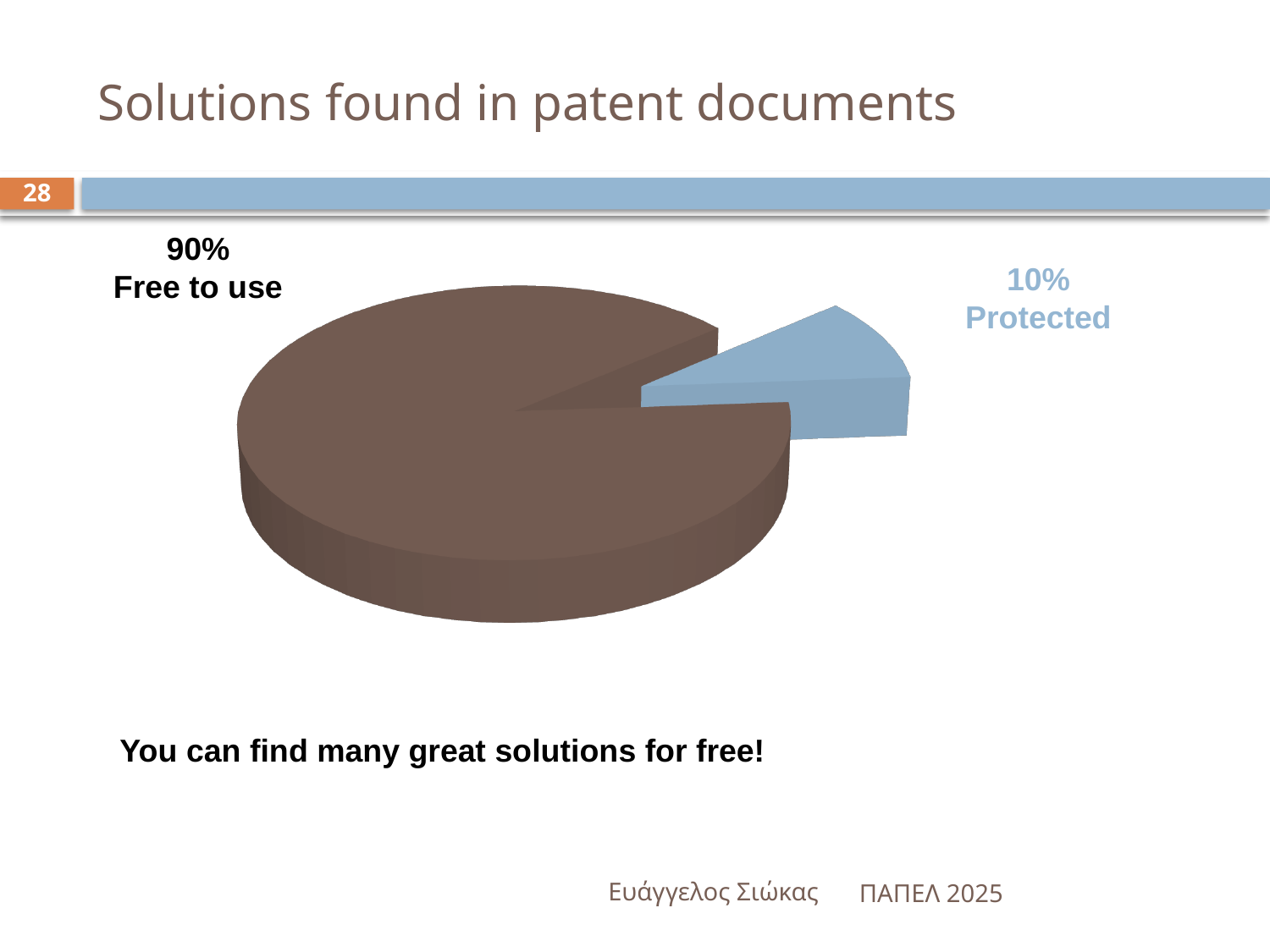
Which is larger, the "Free to use" slice or the "Protected" slice? Free to use What colour is the "Free to use" slice of the pie? brown What is the difference in percentage points between the "Free to use" and "Protected" slices? 80 What share of the pie is labelled "Protected"? 10% What share of the pie is labelled "Free to use"? 90% What colour is the "Protected" slice of the pie? light blue Which slice of the pie is the largest? Free to use Which slice of the pie is the smallest? Protected What kind of chart is shown on the slide? pie chart How many slices does the pie chart have? 2